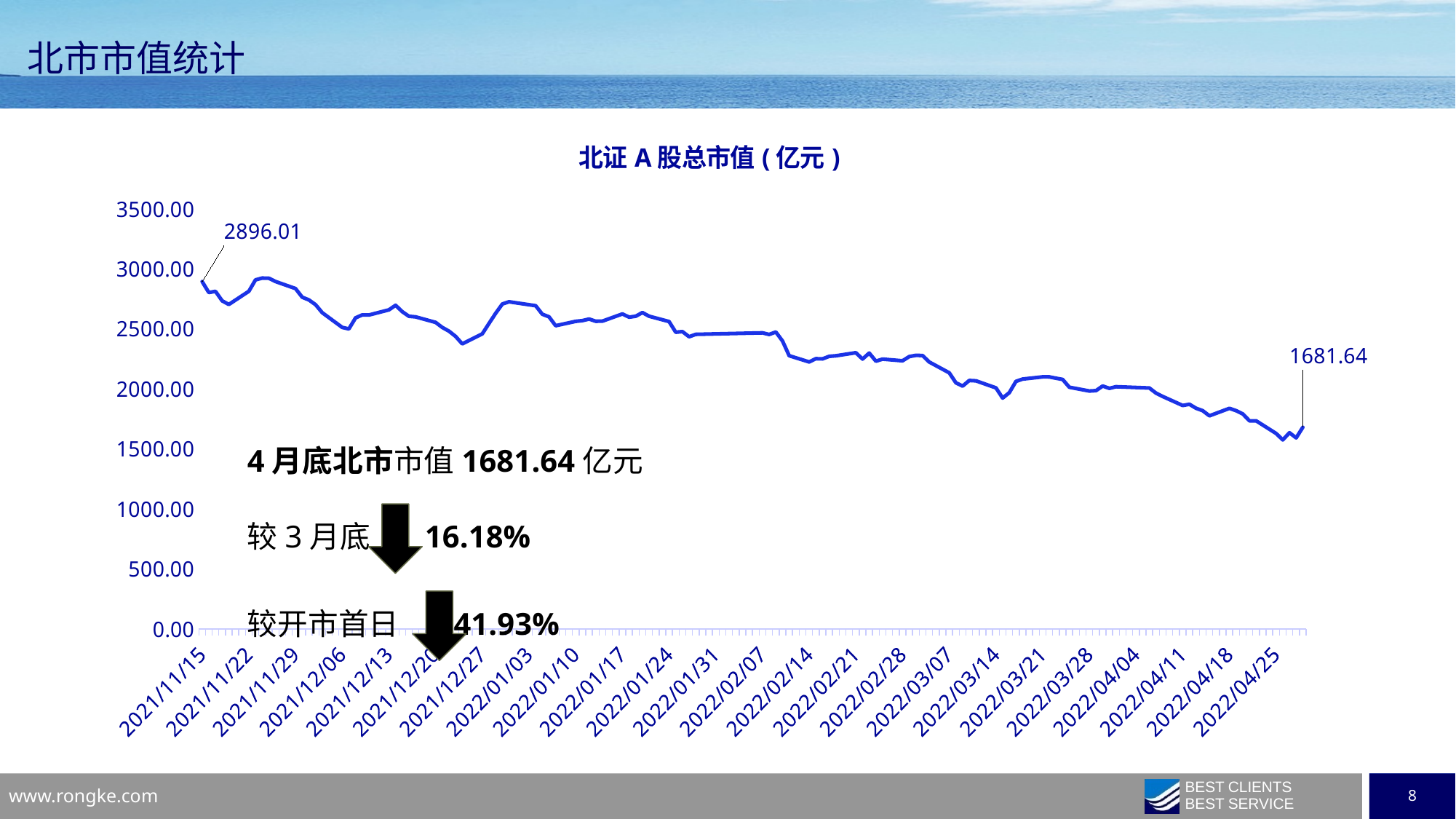
Is the value around 2022/01/03 greater or less than 2500.00? greater Is the value around 2022/02/28 greater or less than 2500.00? less What kind of chart is shown on the slide? Line chart How many date labels are shown on the x axis? 24 Which is larger, the value labelled at the start of the line or the value labelled at the end? The start (2896.01) What is the data label shown at the end of the line (late April 2022)? 1681.64 What is the difference between the first labelled value (2896.01) and the last labelled value (1681.64)? 1214.37 What is the highest value shown on the y axis? 3500.00 What is the title of the chart? 北证A股总市值（亿元） Is the value around 2022/04/18 greater or less than 2000.00? less Does the total market value rise or fall over the period shown on the x axis? Fall What is the data label shown at the start of the line (2021/11/15)? 2896.01